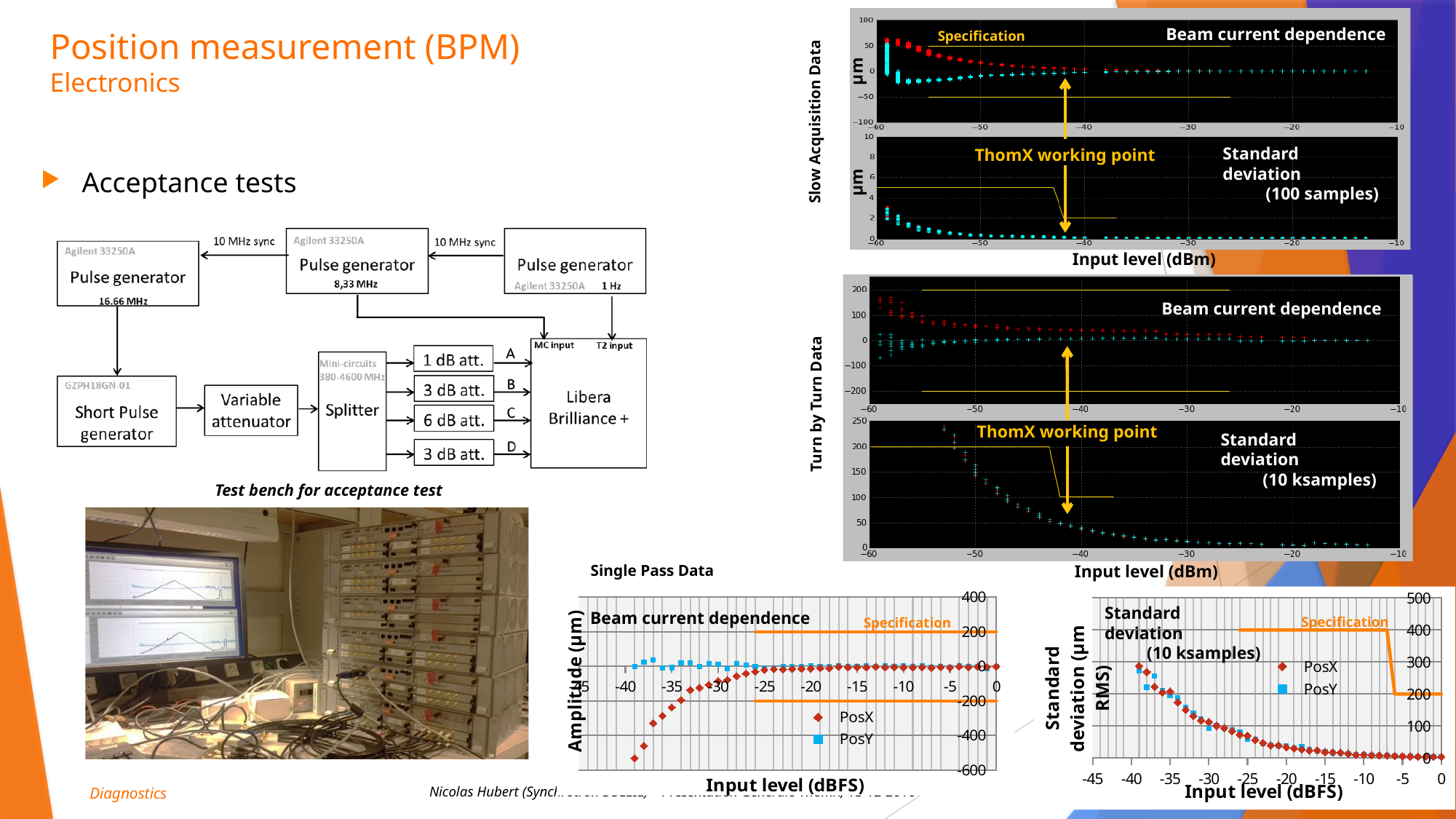
In the 'Turn by Turn Data' Standard deviation (10 ksamples) chart, is the value at -40 dBm greater or less than 100? less In the 'Single Pass Data' Beam current dependence chart, does the PosX series rise or fall as the input level increases from -40 dBFS toward 0 dBFS? rise In the bottom-right 'Standard deviation (10 ksamples)' chart, do the values rise or fall as the input level increases from -40 dBFS to 0 dBFS? fall In the 'Slow Acquisition Data' Standard deviation (100 samples) chart, is the value at -60 dBm greater or less than 4? less What is the x-axis label of the 'Slow Acquisition Data' charts at the top right? Input level (dBm) What kind of chart is the 'Single Pass Data' Beam current dependence chart at the bottom centre? scatter chart How many series does the legend of the 'Single Pass Data' Beam current dependence chart list? 2 What is the y-axis label of the bottom-right 'Standard deviation (10 ksamples)' chart? Standard deviation (µm RMS) In the 'Turn by Turn Data' Standard deviation (10 ksamples) chart, do the values rise or fall as the input level increases from -50 dBm to -10 dBm? fall In the bottom-right 'Standard deviation (10 ksamples)' chart, is the PosX value at -40 dBFS greater or less than 200? greater In the 'Single Pass Data' Beam current dependence chart, what are the two series named in the legend? PosX and PosY